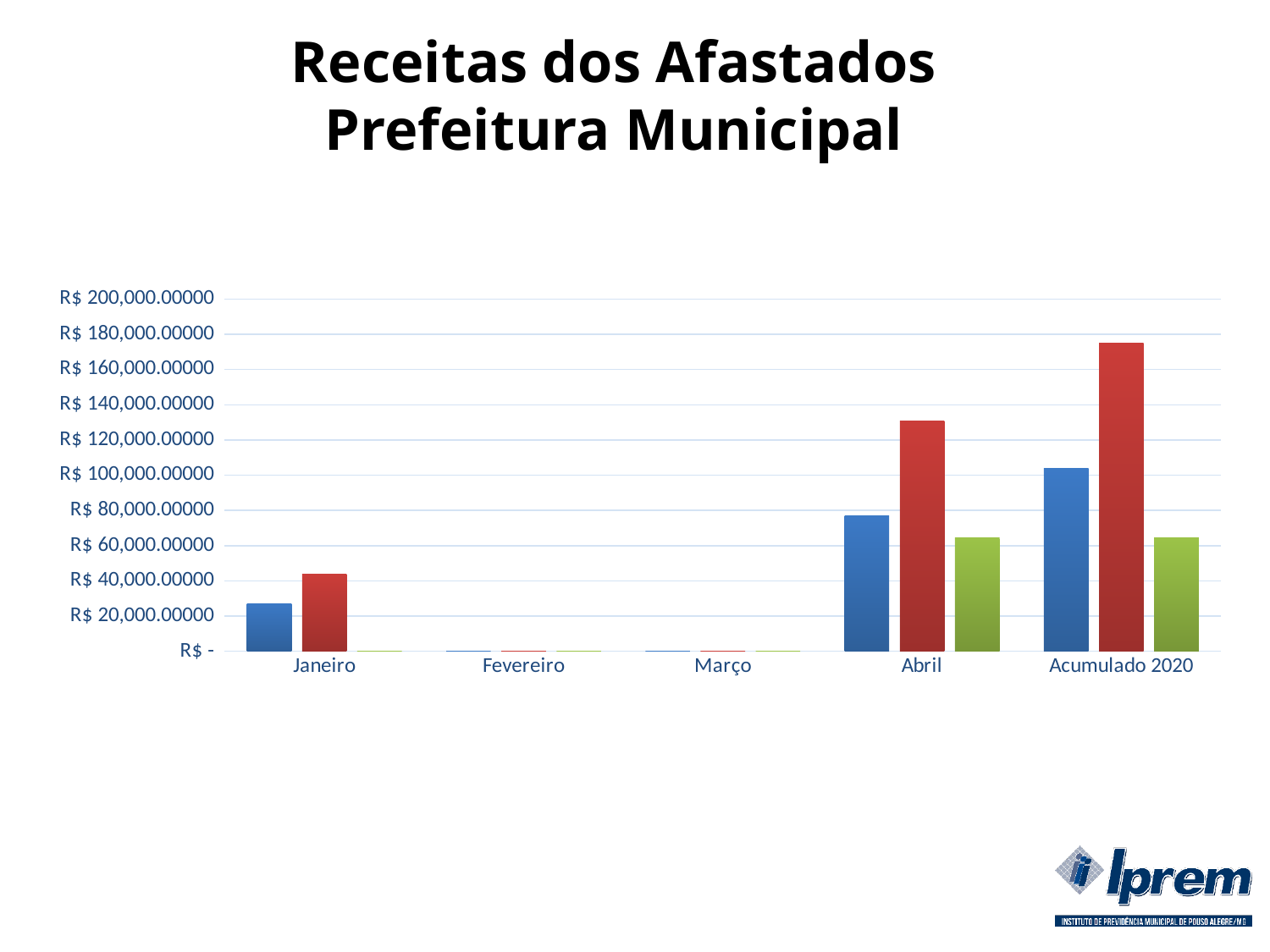
In Abril, which is larger, the red bar or the blue bar? the red bar What kind of chart is shown on the slide? bar chart What is the title of the chart on the slide? Receitas dos Afastados Prefeitura Municipal Is the blue bar for Abril greater or less than R$ 100,000.00000? less Which is larger, the blue bar for Janeiro or the blue bar for Abril? Abril Is the red bar for Abril greater or less than R$ 120,000.00000? greater Is the red bar for Janeiro greater or less than R$ 60,000.00000? less Which category has the tallest red bar? Acumulado 2020 How many categories are shown on the x axis of the chart? 5 Which category has the lowest blue bar among Janeiro, Abril and Acumulado 2020? Janeiro